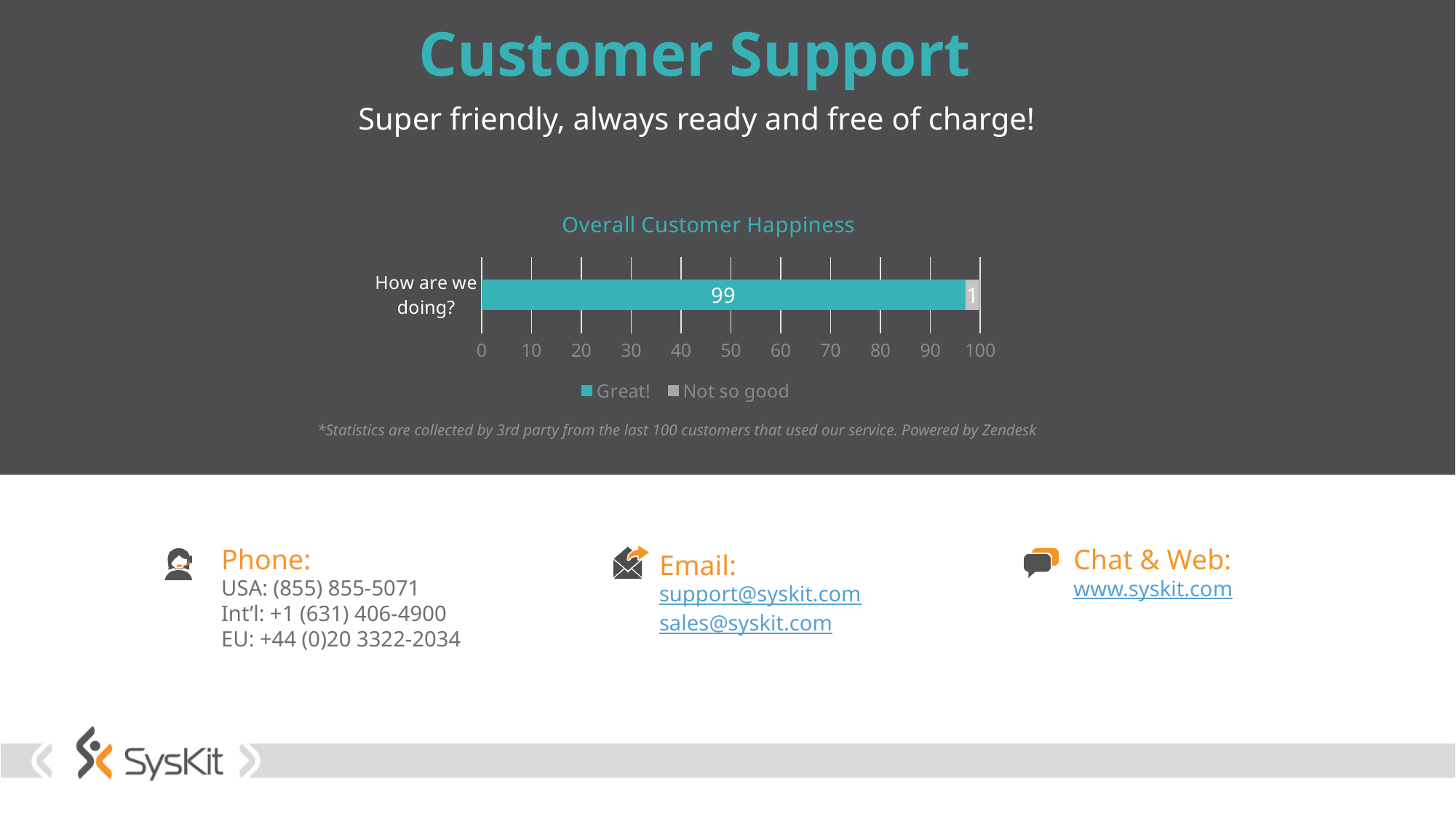
Which series has the larger value, "Great!" or "Not so good"? Great! What is the value for "Great!" in the Overall Customer Happiness chart? 99 How many categories are shown on the chart's vertical axis? 1 What is the value for "Not so good" in the Overall Customer Happiness chart? 1 What is the difference between the "Great!" value and the "Not so good" value? 98 What is the total of the stacked bar for "How are we doing?"? 100 How many series does the legend list? 2 Is the value for "Great!" greater or less than 90? greater What is the label of the category on the chart's vertical axis? How are we doing? What kind of chart is shown on the slide? Bar chart Is the value for "Not so good" greater or less than 10? less What is the title of the chart? Overall Customer Happiness